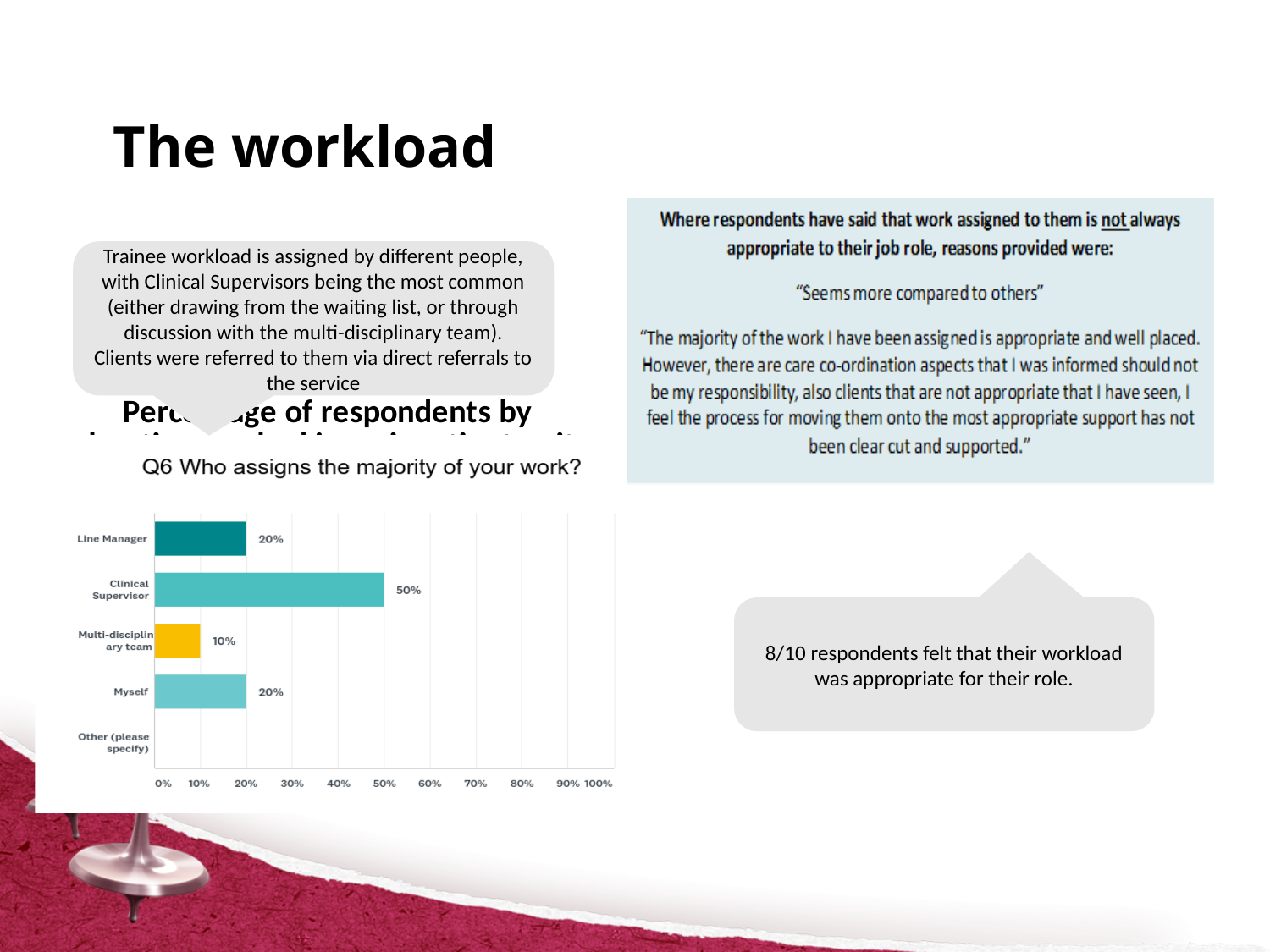
What percentage of respondents said their Line Manager assigns the majority of their work? 20% Among the categories with a visible bar, which has the lowest percentage? Multi-disciplinary team What is the question shown as the title of the chart? Q6 Who assigns the majority of your work? Which is larger, the percentage for Clinical Supervisor or the percentage for Myself? Clinical Supervisor Which category has the highest percentage in the chart? Clinical Supervisor What percentage of respondents said their Clinical Supervisor assigns the majority of their work? 50% How many categories are listed on the vertical axis of the chart? 5 What is the maximum value shown on the horizontal axis of the chart? 100% What is the difference in percentage points between Clinical Supervisor and Line Manager? 30 What percentage of respondents said they assign the majority of their work themselves (Myself)? 20% What type of chart is used to show who assigns the majority of respondents' work? Bar chart What percentage of respondents said the Multi-disciplinary team assigns the majority of their work? 10%